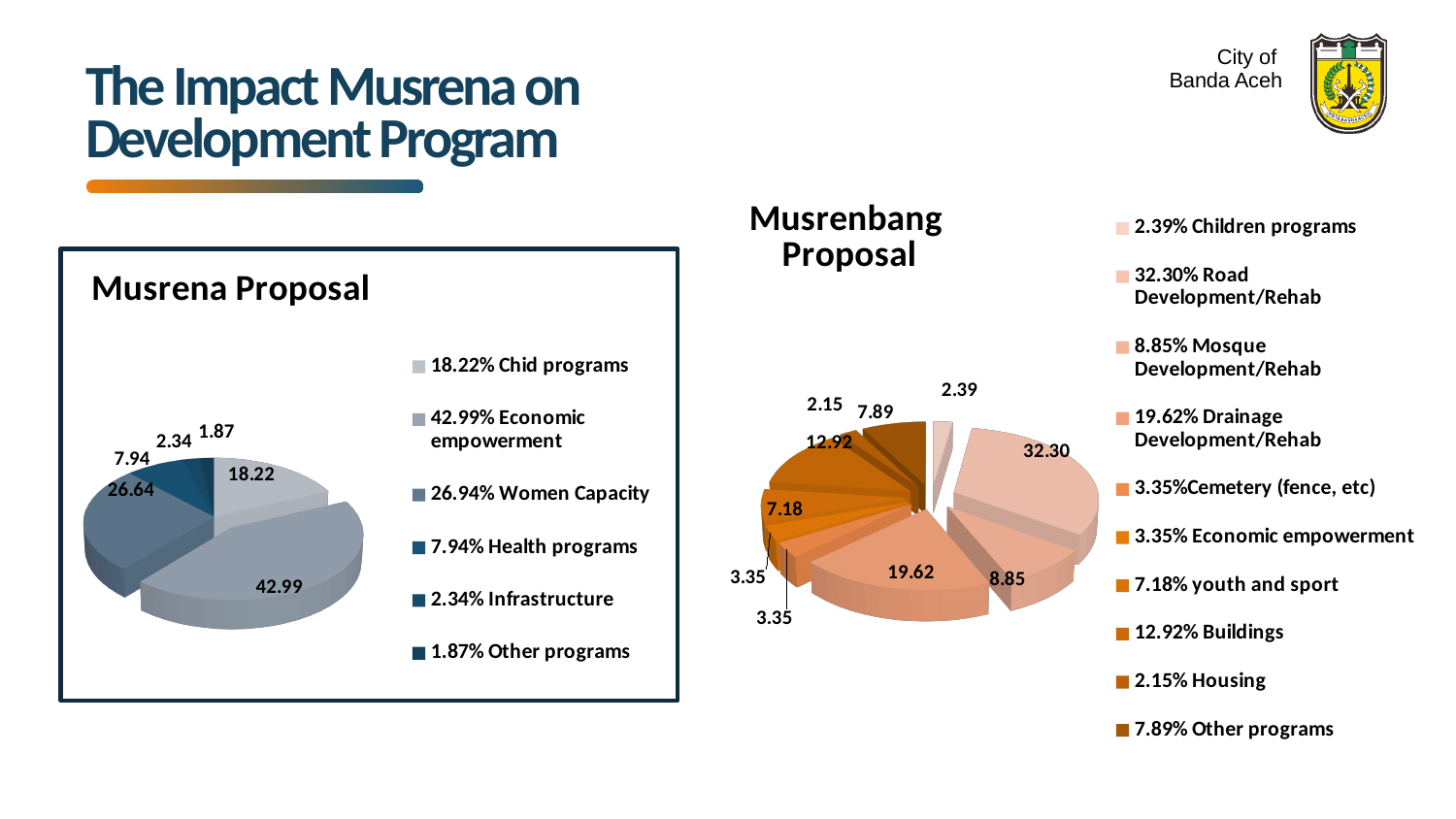
In the Musrenbang Proposal chart, which category has the largest slice? Road Development/Rehab How many categories does the legend of the Musrenbang Proposal chart list? 10 In the Musrenbang Proposal chart, what is the value for Buildings? 12.92 In the Musrenbang Proposal chart, what is the difference between the values for Road Development/Rehab and Mosque Development/Rehab? 23.45 In the Musrena Proposal chart, what is the value for Health programs? 7.94 In the Musrenbang Proposal chart, which category has the smallest slice? Housing In the Musrena Proposal chart, what is the value for Economic empowerment? 42.99 In the Musrenbang Proposal chart, what is the value for Drainage Development/Rehab? 19.62 What kind of chart is the Musrena Proposal chart? pie chart In the Musrena Proposal chart, which category has the smallest slice? Other programs In the Musrena Proposal chart, which category has the largest slice? Economic empowerment How many categories does the legend of the Musrena Proposal chart list? 6